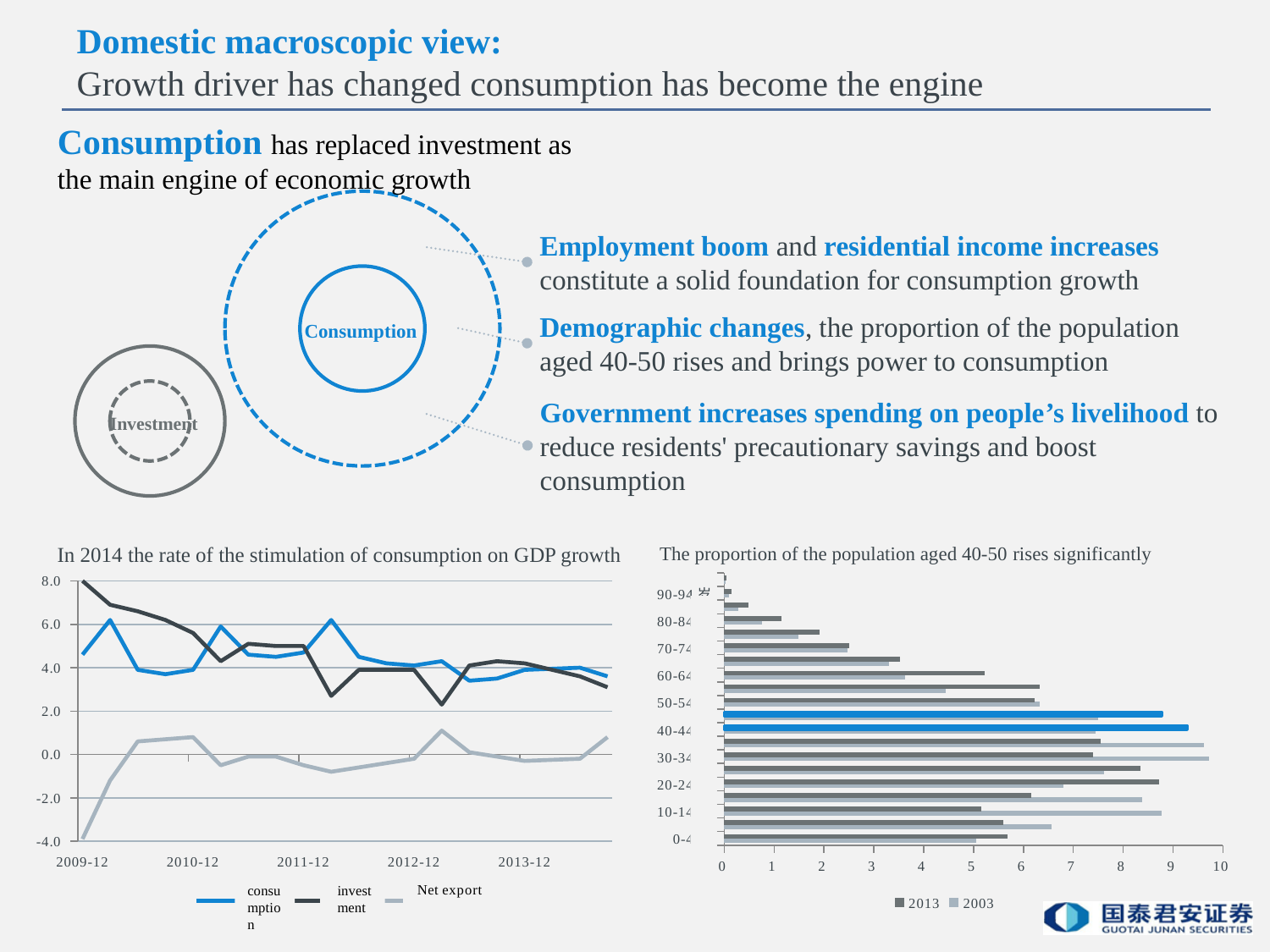
In the right chart, for the 40-44 age group, which year has the larger value: 2013 or 2003? 2013 What kind of chart is the right chart titled "The proportion of the population aged 40-50 rises significantly"? bar chart In the left chart, how many series does the legend list? 3 In the left chart, is the value for investment at 2009-12 greater or less than 6.0? greater In the right chart, which two years are listed in the legend? 2013 and 2003 In the left chart, is the value for Net export at 2009-12 greater or less than -2.0? less In the right chart, is the 2013 value for the 40-44 age group greater or less than 8? greater In the left chart, at 2009-12, which is higher: consumption or investment? investment What kind of chart is the left chart titled "In 2014 the rate of the stimulation of consumption on GDP growth"? line chart In the right chart, how many series does the legend list? 2 In the left chart, does the investment line generally rise or fall from 2009-12 to the end of the series? fall